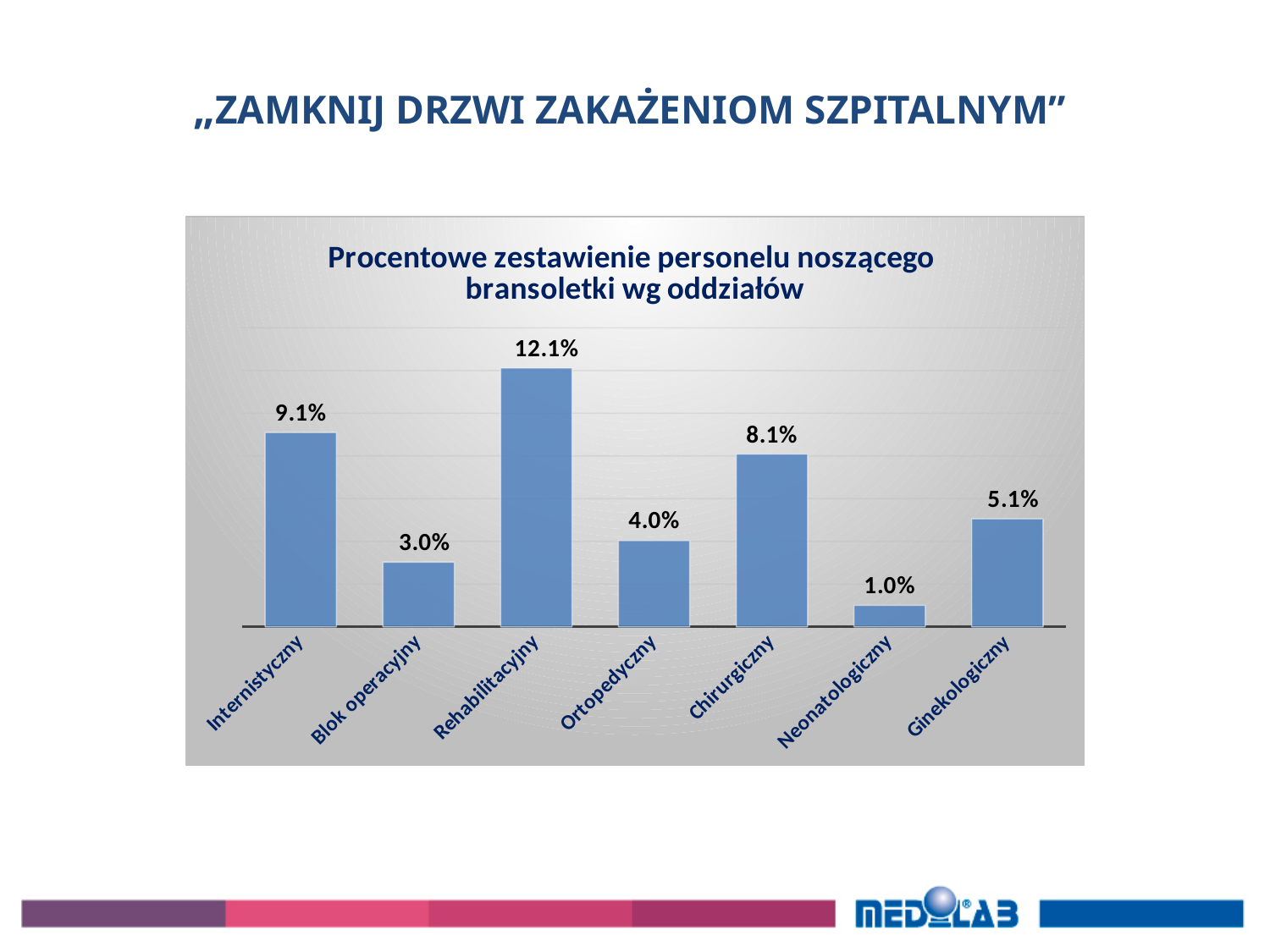
Which category has the lowest value? Neonatologiczny What is the difference between the values for Rehabilitacyjny and Chirurgiczny? 4.0% Which is larger, the value for Chirurgiczny or the value for Ortopedyczny? Chirurgiczny What is the difference between the values for Internistyczny and Ginekologiczny? 4.0% How many categories are shown on the x axis? 7 What is the value for Blok operacyjny? 3.0% What is the value for Ortopedyczny? 4.0% What is the title of the chart? Procentowe zestawienie personelu noszącego bransoletki wg oddziałów What is the value for Internistyczny? 9.1% What kind of chart is shown on the slide? Bar chart What is the value for Ginekologiczny? 5.1% Which category has the highest value? Rehabilitacyjny